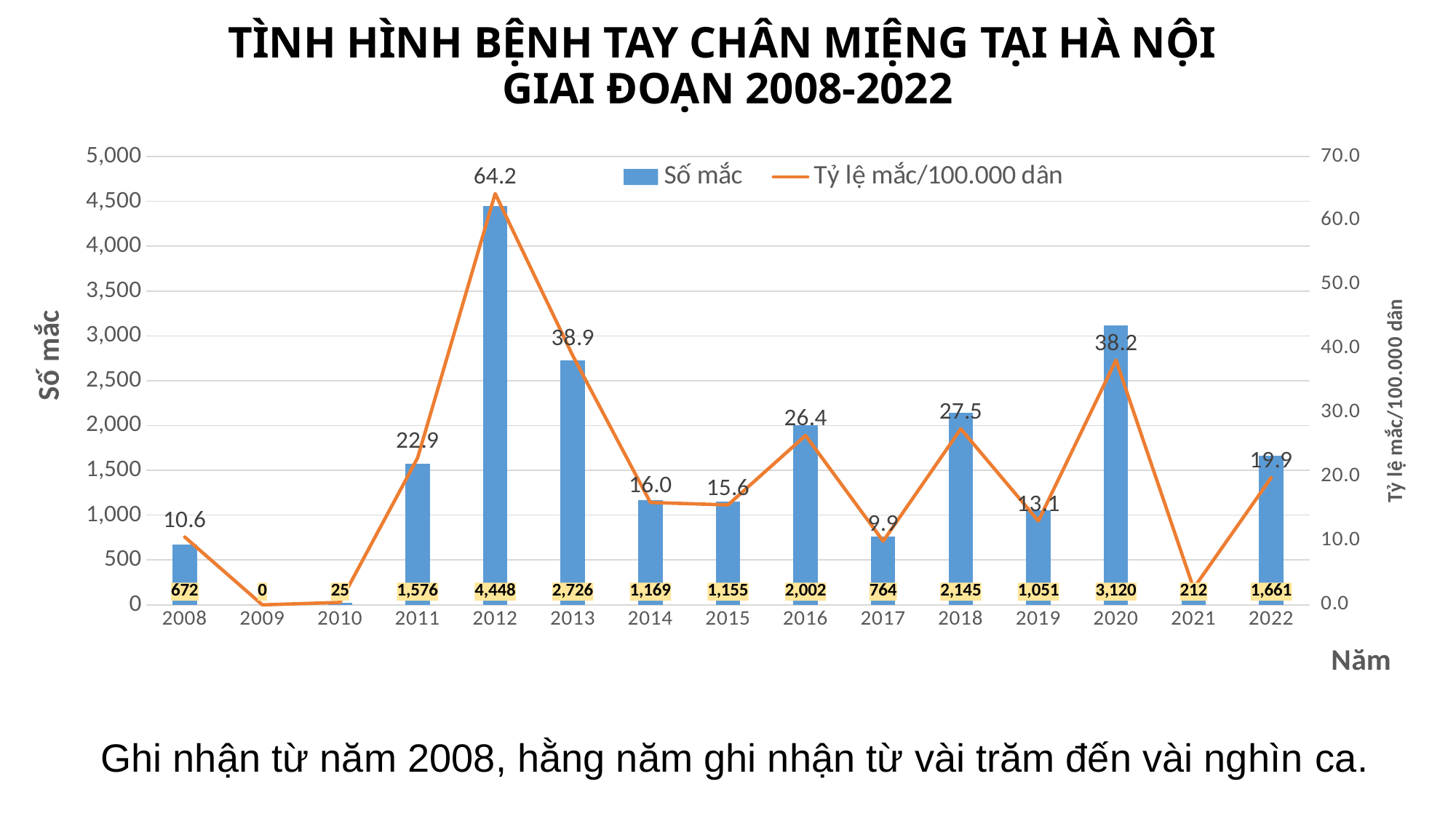
Does the Tỷ lệ mắc/100.000 dân line rise or fall from 2012 to 2014? fall Is the Tỷ lệ mắc/100.000 dân value for 2021 greater or less than 10.0? less What is the value of Số mắc for 2021? 212 What is the Tỷ lệ mắc/100.000 dân value for 2020? 38.2 Which year has the highest Số mắc? 2012 Which year has the lowest Số mắc? 2009 What kind of chart is this? Combined bar and line chart What is the value of Số mắc for 2012? 4,448 Which year has the larger Số mắc, 2016 or 2018? 2018 What is the difference in Số mắc between 2020 and 2013? 394 How many series does the legend list? 2 How many years are shown on the x axis? 15